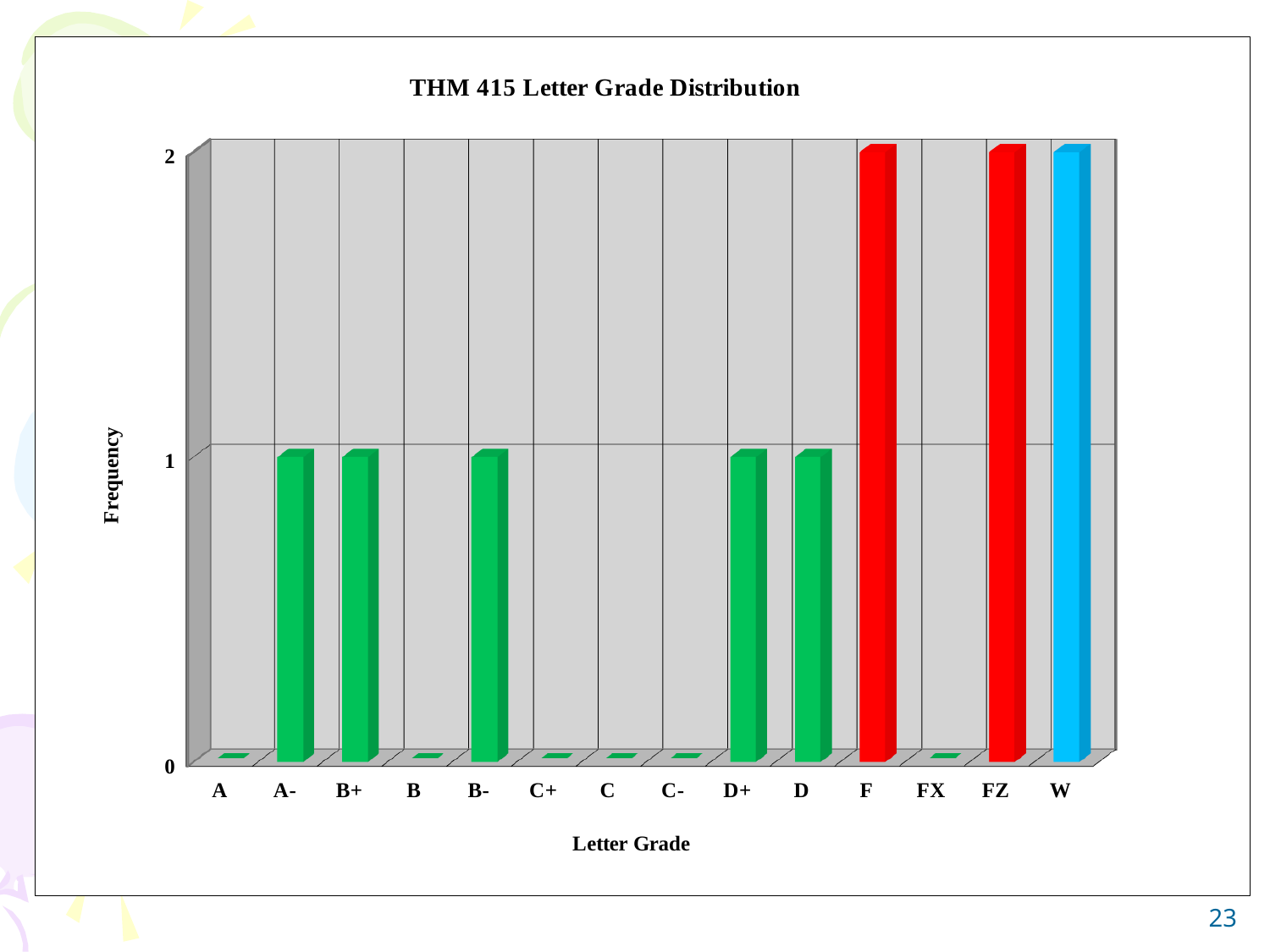
What kind of chart is shown on the slide? Bar chart What is the frequency for letter grade A-? 1 How many letter grade categories are shown on the x axis? 14 What is the frequency for letter grade C? 0 What is the label of the vertical axis? Frequency What is the frequency for letter grade D+? 1 What is the title of the chart? THM 415 Letter Grade Distribution Which has a higher frequency, B+ or B? B+ What is the difference between the frequency for FZ and the frequency for B-? 1 What is the frequency for letter grade F? 2 What is the frequency for letter grade W? 2 Which has a higher frequency, F or D? F